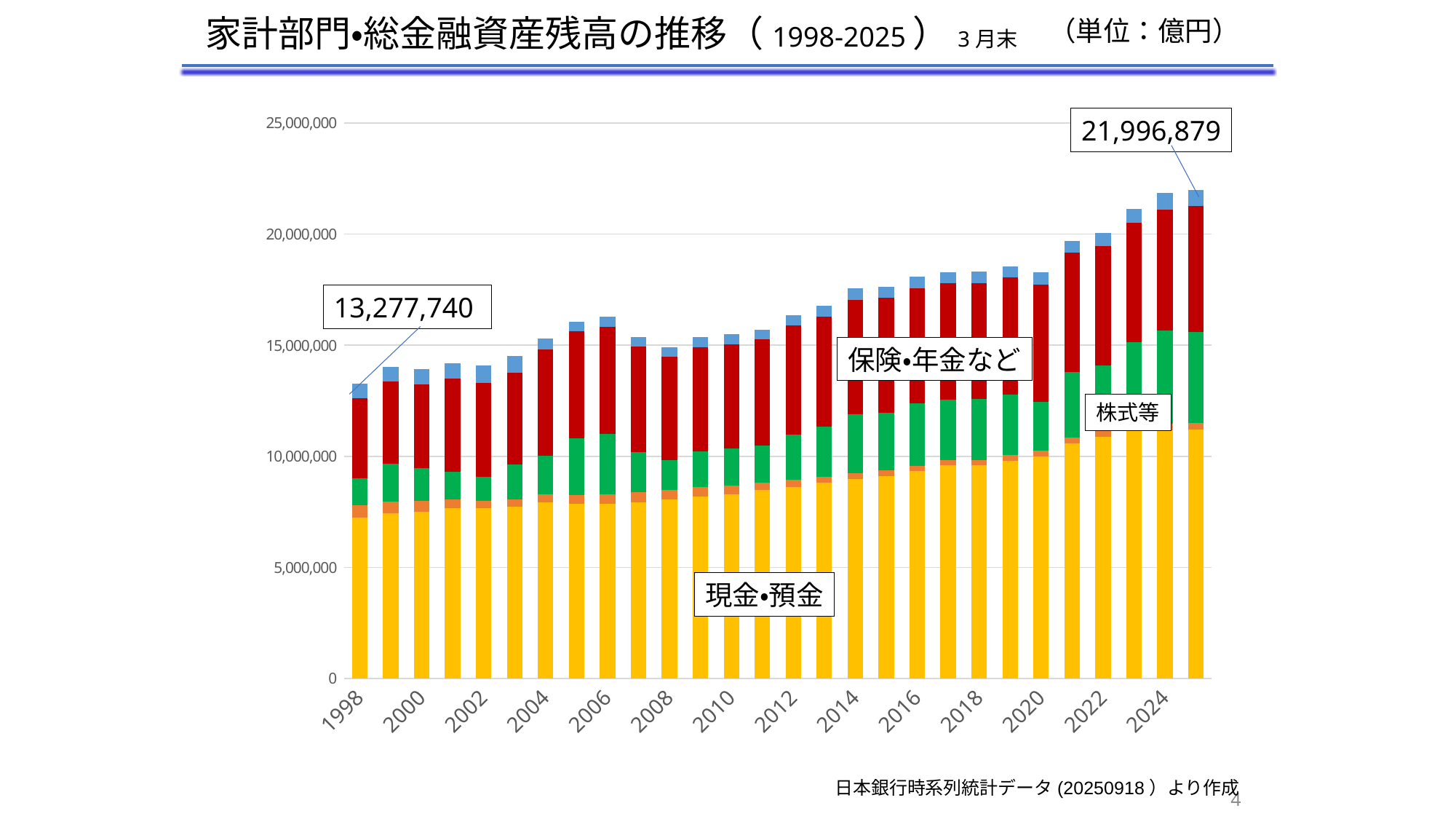
Is the total balance for 2010 greater or less than 15,000,000? greater What kind of chart is shown on the slide? Stacked bar chart Which year has the lowest total balance? 1998 Which year has the larger total balance, 2005 or 2009? 2005 Do the total balances generally rise or fall from 1998 to 2025? Rise By how much did the total balance increase from 1998 to 2025, using the two labelled values? 8,719,139 How many years (bars) are plotted in the chart? 28 What is the total household financial asset balance shown for 1998? 13,277,740 Which year has the highest total balance? 2025 What unit is stated for the values in the chart? 億円 What is the total household financial asset balance shown for 2025? 21,996,879 Is the total balance for 2013 greater or less than 20,000,000? less